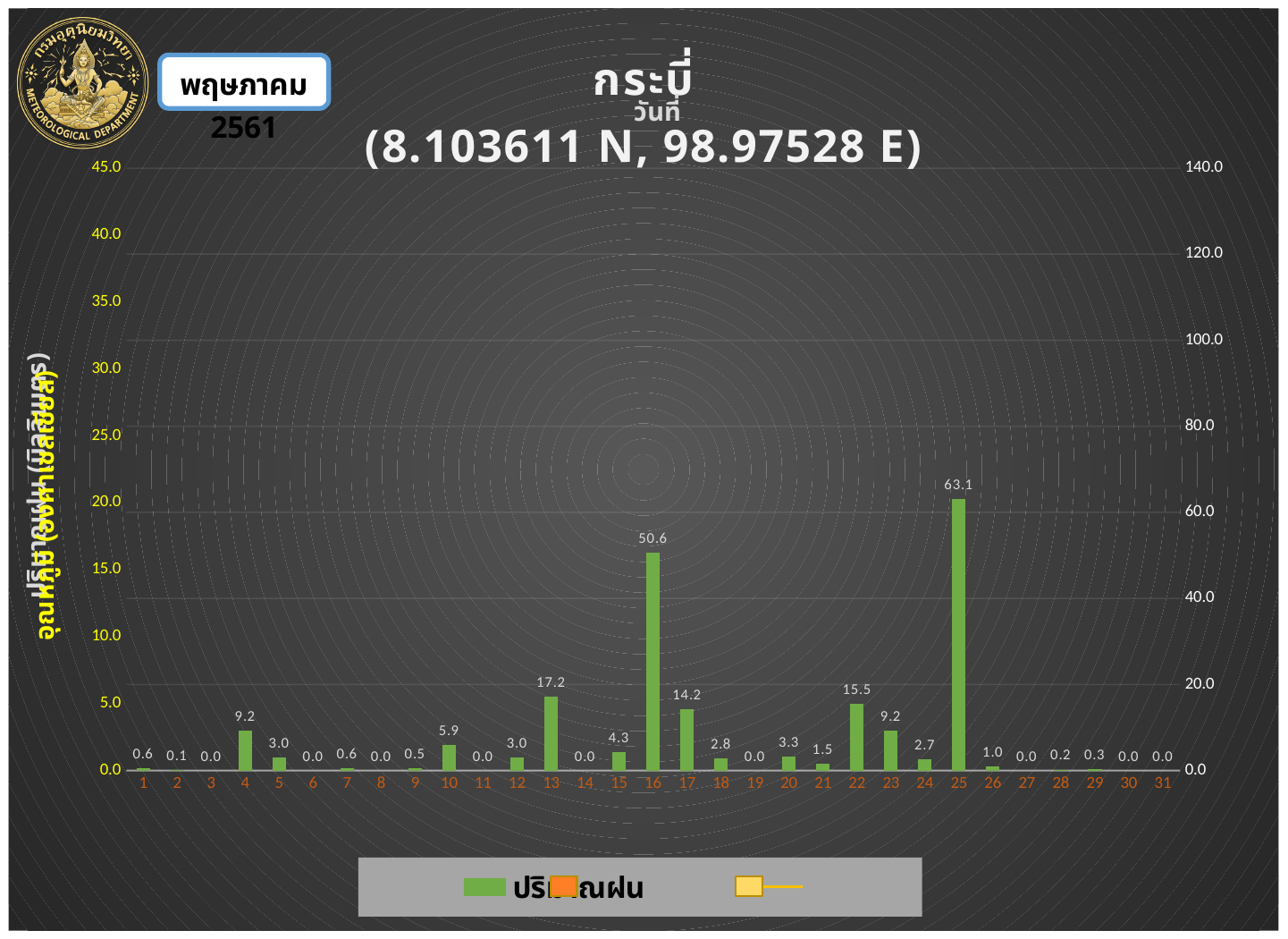
What is the rainfall value shown for day 4? 9.2 What kind of chart is shown on the slide? Bar chart Which has the larger rainfall value, day 13 or day 17? Day 13 How many days are shown on the x axis? 31 What is the rainfall value shown for day 13? 17.2 What is the difference between the rainfall values for day 22 and day 23? 6.3 What are the coordinates shown in the chart title? 8.103611 N, 98.97528 E What is the rainfall value shown for day 16? 50.6 What is the difference between the rainfall values for day 25 and day 16? 12.5 Which day has the highest rainfall value? 25 What is the rainfall value shown for day 25? 63.1 What is the rainfall value shown for day 22? 15.5